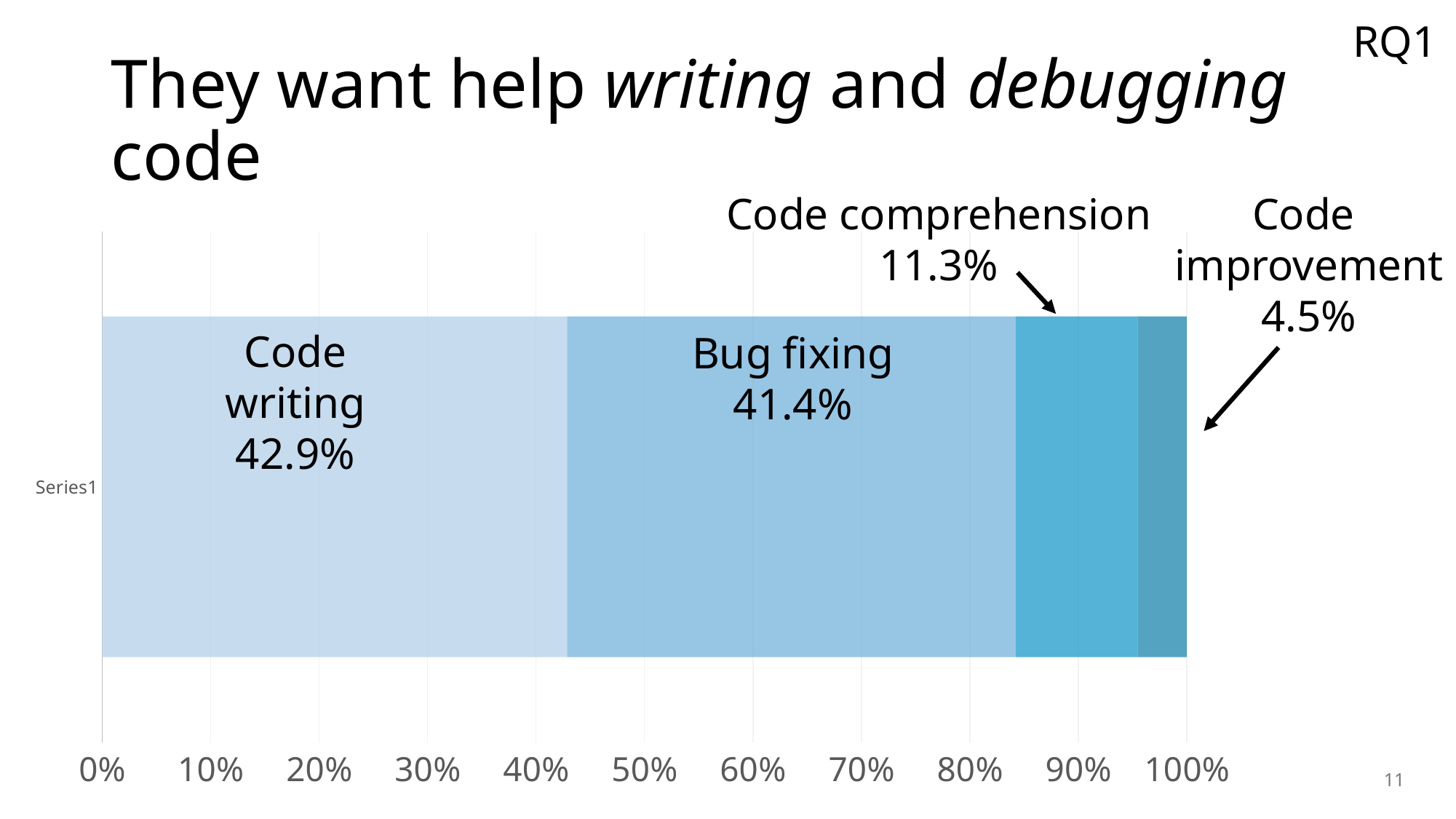
What is the difference between the Code comprehension and Code improvement percentages? 6.8% What percentage is shown for Code writing? 42.9% What kind of chart is shown on the slide? Stacked bar chart What percentage is shown for Code improvement? 4.5% Which segment has the smallest percentage? Code improvement What is the difference between the Code writing and Bug fixing percentages? 1.5% What percentage is shown for Bug fixing? 41.4% Which is larger, Code comprehension or Code improvement? Code comprehension How many segments make up the stacked bar? 4 What percentage is shown for Code comprehension? 11.3% What is the label shown on the vertical axis for the bar? Series1 Which segment has the largest percentage? Code writing